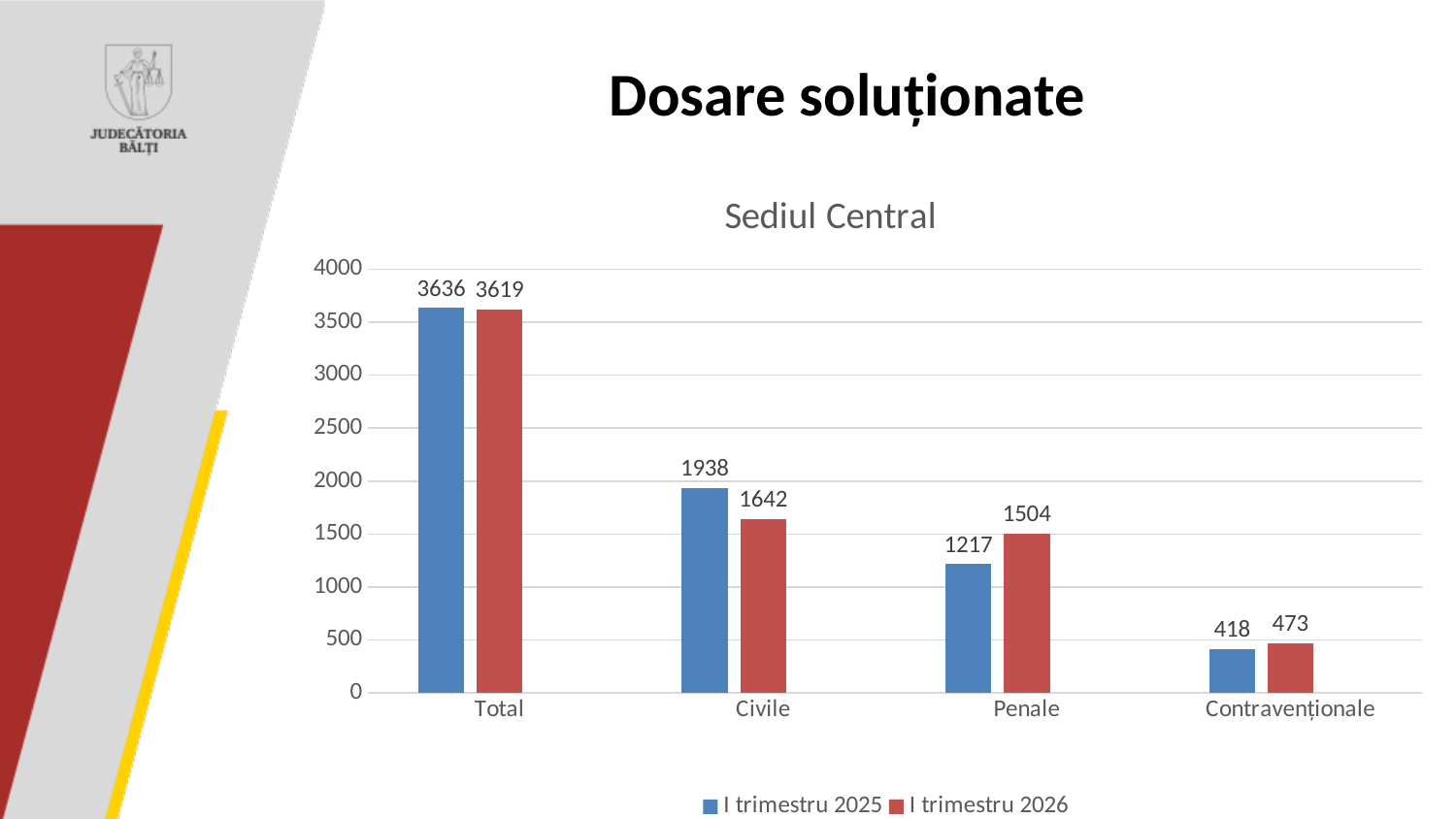
What is the value for Total in I trimestru 2026? 3619 What is the value for Civile in I trimestru 2025? 1938 What is the value for Penale in I trimestru 2026? 1504 How many series does the legend list? 2 Which category has the lowest value in I trimestru 2026? Contravenționale What is the difference between the I trimestru 2026 and I trimestru 2025 values for Penale? 287 Which is larger for Contravenționale: I trimestru 2025 or I trimestru 2026? I trimestru 2026 How many categories are shown on the x axis? 4 Which category has the highest value in I trimestru 2025? Total What is the value for Contravenționale in I trimestru 2025? 418 What type of chart is shown on the slide? Bar chart What is the difference between the I trimestru 2025 and I trimestru 2026 values for Civile? 296